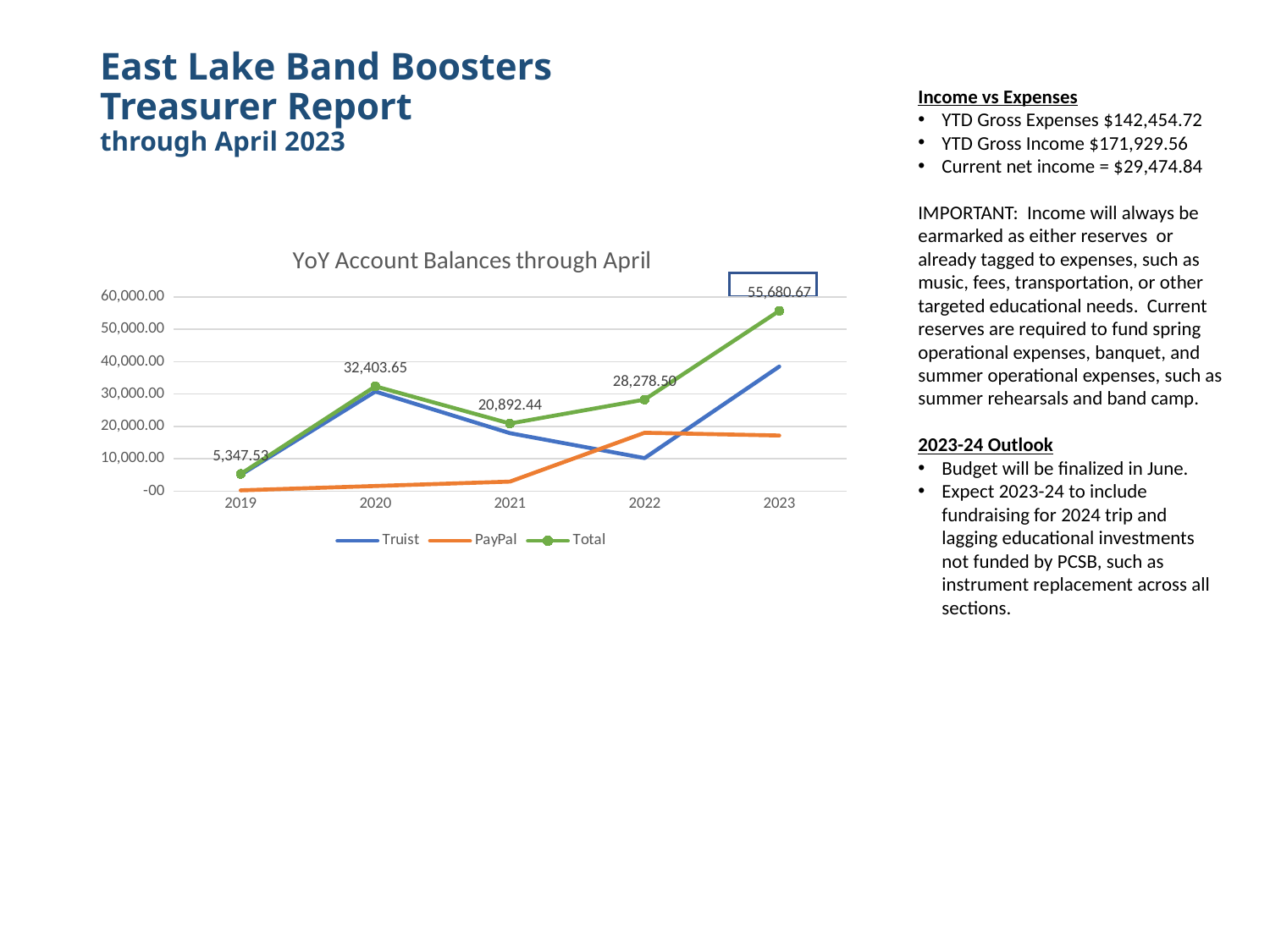
What is the Total account balance shown for 2021? 20,892.44 Which year had a higher Total balance, 2020 or 2021? 2020 What is the Total account balance shown for 2019? 5,347.53 By how much did the Total balance increase from 2022 to 2023? 27,402.17 What is the Total account balance shown for 2023? 55,680.67 How many years are plotted on the x axis of the chart? 5 In which year is the Total account balance lowest? 2019 What type of chart is used to show the YoY account balances? Line chart Is the Truist balance for 2023 greater or less than 30,000.00? greater Is the PayPal balance for 2021 greater or less than 10,000.00? less In which year is the Total account balance highest? 2023 How many series does the chart legend list? 3